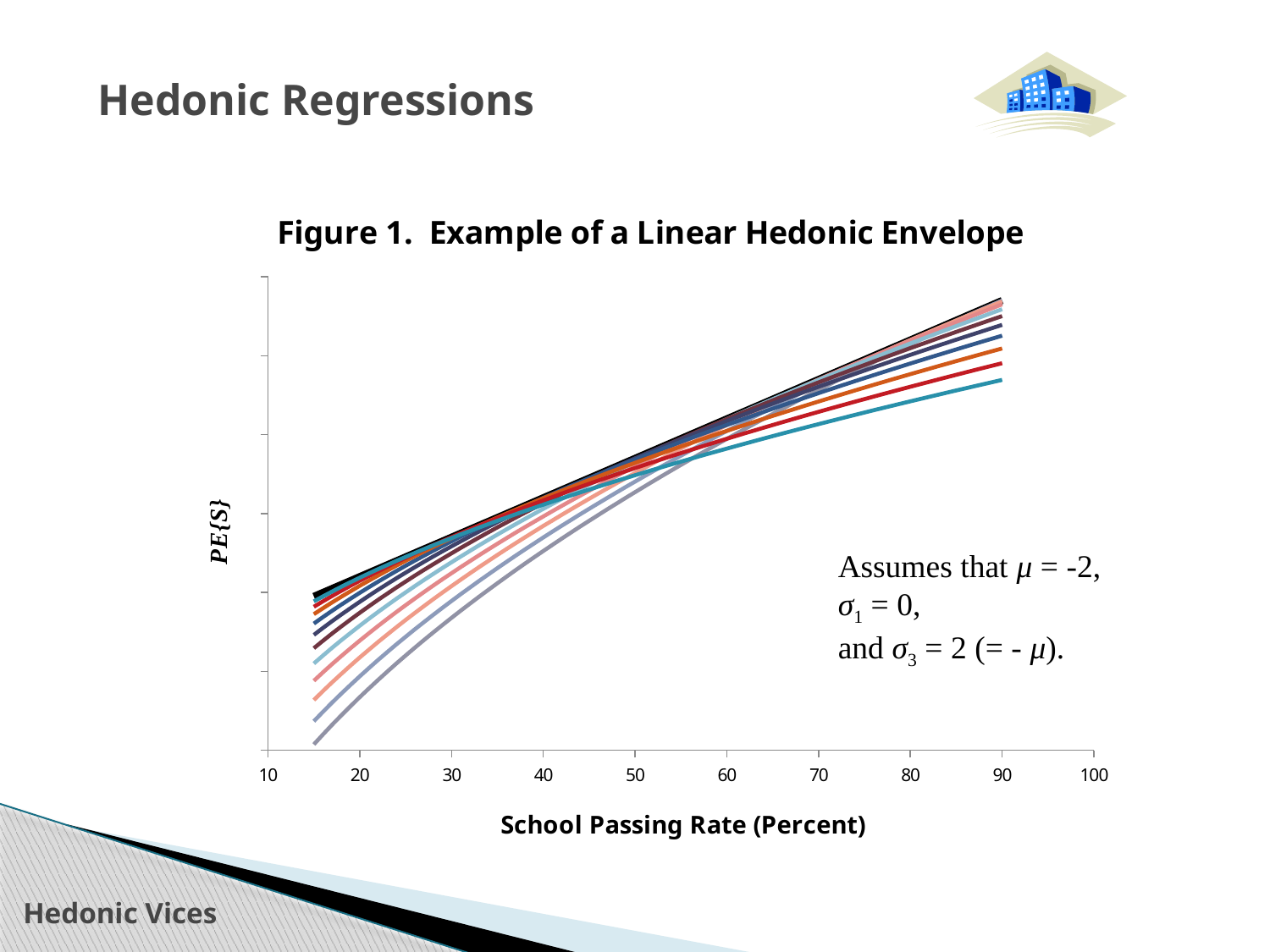
At the right end of the chart (x = 90), is the straight black line above or below the teal line? above What is the title of the chart? Figure 1. Example of a Linear Hedonic Envelope Is the x value at which the plotted lines end greater or less than 80? greater Do the plotted lines rise or fall as School Passing Rate increases? rise Is the x value at which the plotted lines begin greater or less than 20? less What is the highest tick value shown on the x axis? 100 What is the spacing between consecutive tick labels on the x axis? 10 What kind of chart is shown in Figure 1? line chart What is the label on the x axis of the chart? School Passing Rate (Percent) Does the chart display numeric tick labels on the y axis? No What is the lowest tick value shown on the x axis? 10